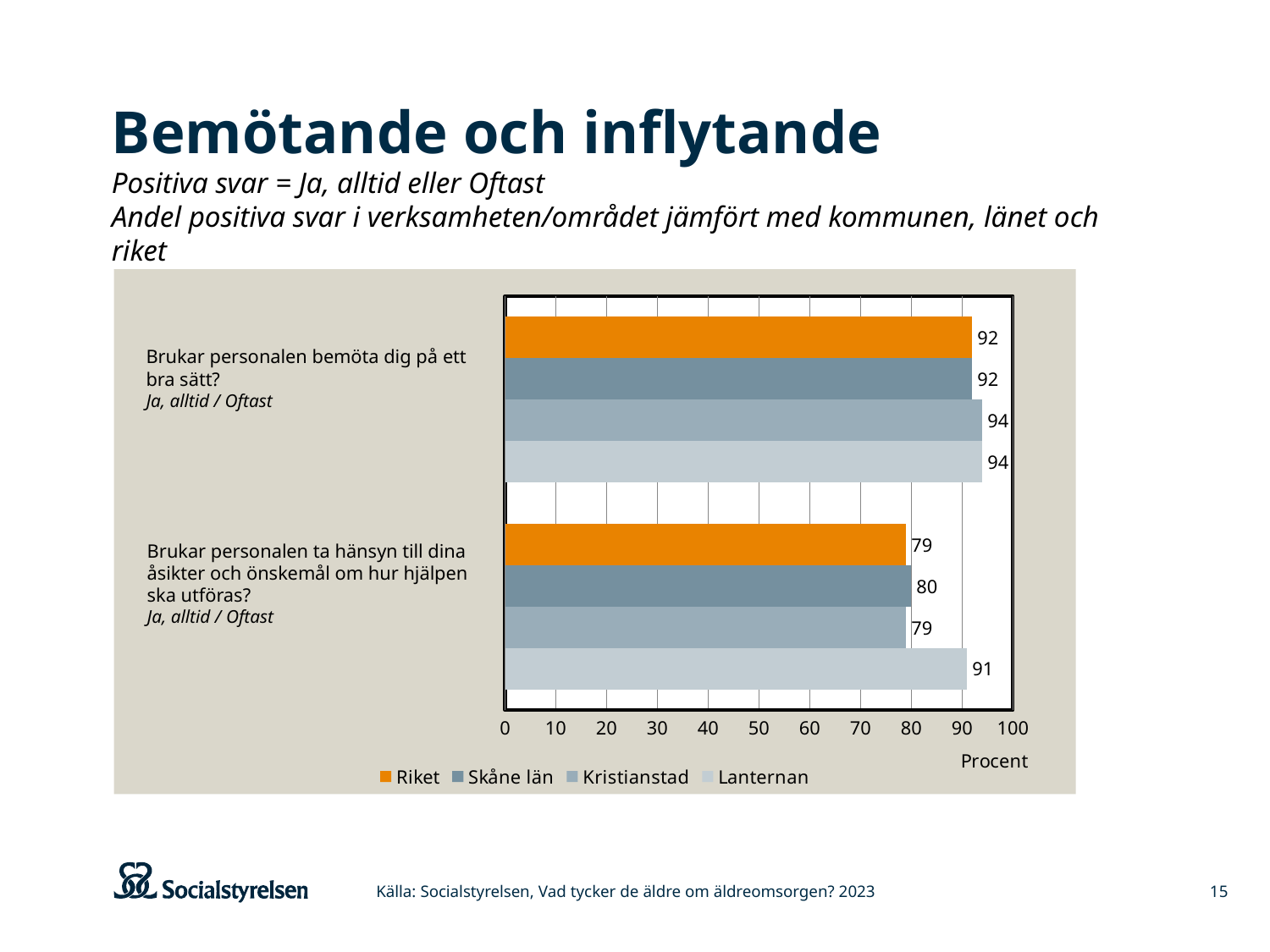
For the question "Brukar personalen ta hänsyn till dina åsikter och önskemål om hur hjälpen ska utföras?", which series has the highest value? Lanternan What is the difference between the Lanternan value and the Riket value for the question "Brukar personalen ta hänsyn till dina åsikter och önskemål om hur hjälpen ska utföras?"? 12 How many survey questions (categories) are shown on the chart? 2 What is the difference between the Kristianstad value and the Riket value for the question "Brukar personalen bemöta dig på ett bra sätt?"? 2 What is the value for Lanternan for the question "Brukar personalen ta hänsyn till dina åsikter och önskemål om hur hjälpen ska utföras?"? 91 What is the value for Riket for the question "Brukar personalen bemöta dig på ett bra sätt?"? 92 Which is larger: the Lanternan value for "Brukar personalen bemöta dig på ett bra sätt?" or the Lanternan value for "Brukar personalen ta hänsyn till dina åsikter och önskemål om hur hjälpen ska utföras?"? Brukar personalen bemöta dig på ett bra sätt? What is the value for Kristianstad for the question "Brukar personalen bemöta dig på ett bra sätt?"? 94 What unit is shown on the horizontal axis of the chart? Procent What is the value for Skåne län for the question "Brukar personalen ta hänsyn till dina åsikter och önskemål om hur hjälpen ska utföras?"? 80 What kind of chart is shown on the slide? bar chart How many series does the legend list? 4